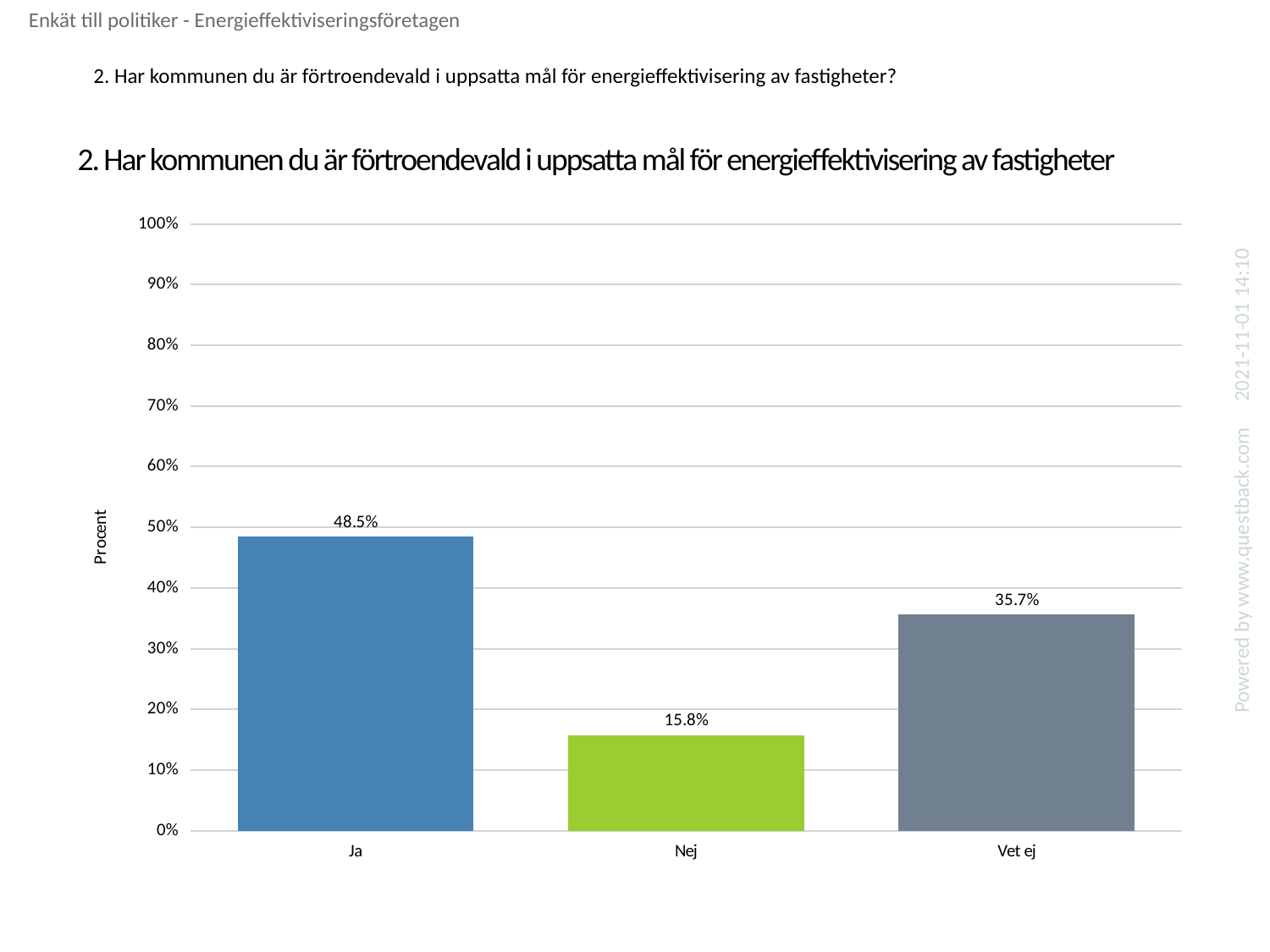
Is the value for Ja greater or less than 50%? less Which is larger, the value for Nej or the value for Vet ej? Vet ej What is the label of the y axis? Procent What kind of chart is shown on the slide? bar chart What is the value for Vet ej? 35.7% How many categories are shown on the x axis? 3 Which category has the highest value? Ja What is the value for Nej? 15.8% Which category has the lowest value? Nej What is the value for Ja? 48.5% What is the difference between the values for Ja and Vet ej? 12.8% What is the difference between the values for Vet ej and Nej? 19.9%